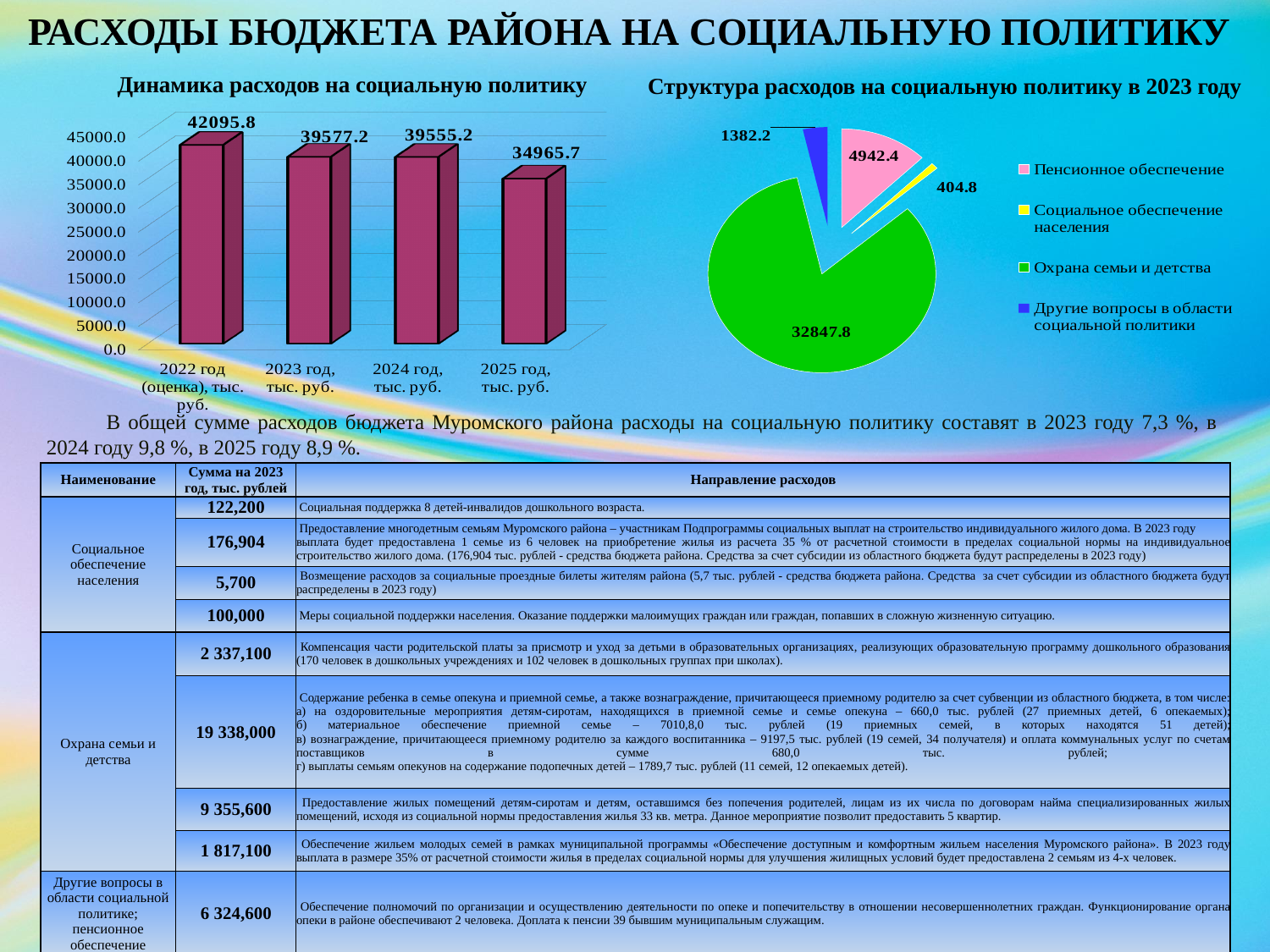
In the bar chart 'Динамика расходов на социальную политику', what is the difference between the 2022 value and the 2025 value? 7130.1 What kind of chart is 'Динамика расходов на социальную политику'? bar chart How many bars are in the bar chart 'Динамика расходов на социальную политику'? 4 How many categories does the legend of the pie chart 'Структура расходов на социальную политику в 2023 году' list? 4 In the bar chart 'Динамика расходов на социальную политику', what is the value for '2025 год'? 34965.7 In the pie chart 'Структура расходов на социальную политику в 2023 году', which category has the smallest value? Социальное обеспечение населения In the pie chart 'Структура расходов на социальную политику в 2023 году', what is the value for 'Охрана семьи и детства'? 32847.8 In the pie chart 'Структура расходов на социальную политику в 2023 году', which is larger: 'Пенсионное обеспечение' or 'Другие вопросы в области социальной политики'? Пенсионное обеспечение In the bar chart 'Динамика расходов на социальную политику', do the values rise or fall from 2022 to 2025? fall In the bar chart 'Динамика расходов на социальную политику', what is the value for '2022 год (оценка)'? 42095.8 In the bar chart 'Динамика расходов на социальную политику', which year has the lowest value? 2025 год In the bar chart 'Динамика расходов на социальную политику', which year has the highest value? 2022 год (оценка)